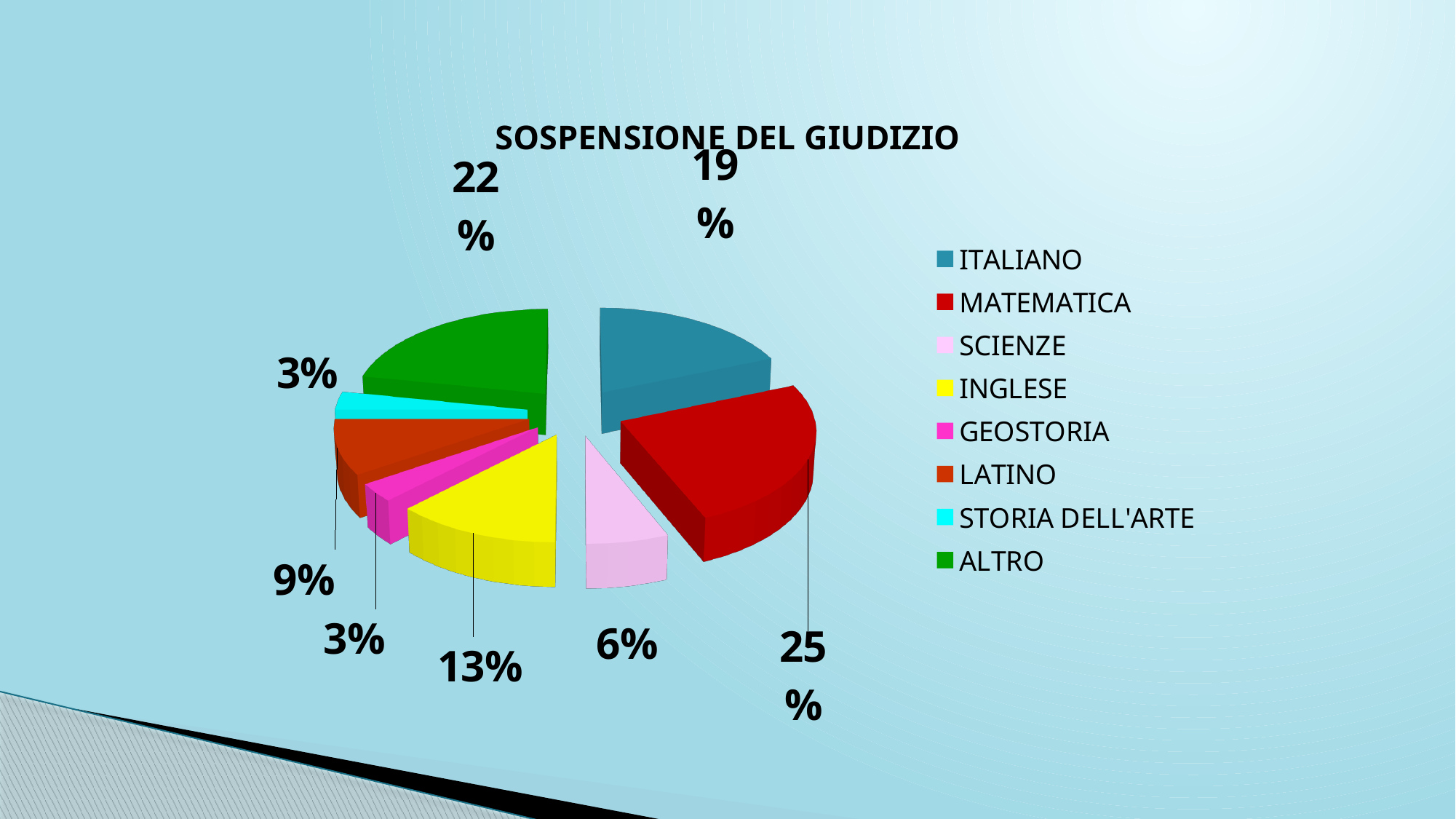
Which category has the largest slice of the pie? MATEMATICA Which is larger, the SCIENZE slice or the INGLESE slice? INGLESE What is the difference between the MATEMATICA and ITALIANO percentages? 6% What is the title of the chart? SOSPENSIONE DEL GIUDIZIO What percentage does the MATEMATICA slice show? 25% What kind of chart is shown on the slide? pie chart How many categories does the legend list? 8 What colour is the ALTRO slice? green What percentage does the LATINO slice show? 9% What percentage does the ITALIANO slice show? 19% What percentage does the INGLESE slice show? 13% What percentage does the ALTRO slice show? 22%